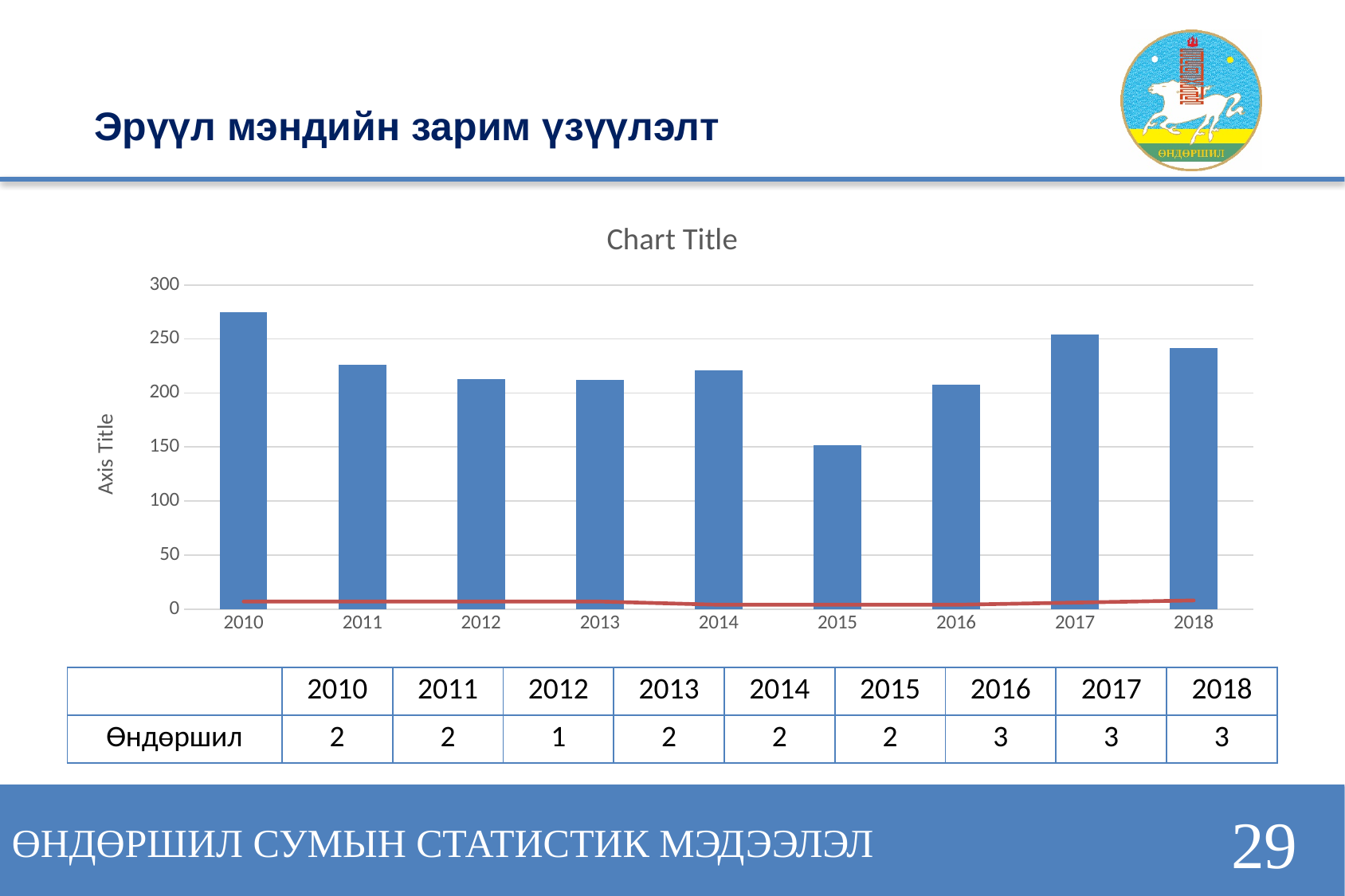
Which year has the larger bar, 2017 or 2018? 2017 What is the label on the vertical axis? Axis Title What kind of chart is shown on the slide? combination bar and line chart Is the bar value for 2010 greater or less than 250? greater What is the title shown above the chart? Chart Title Is the bar value for 2015 greater or less than 200? less How many years are shown on the x axis? 9 Is the bar value for 2011 greater or less than 200? greater Which year has the shortest bar? 2015 Which year has the larger bar, 2010 or 2011? 2010 Which year has the tallest bar? 2010